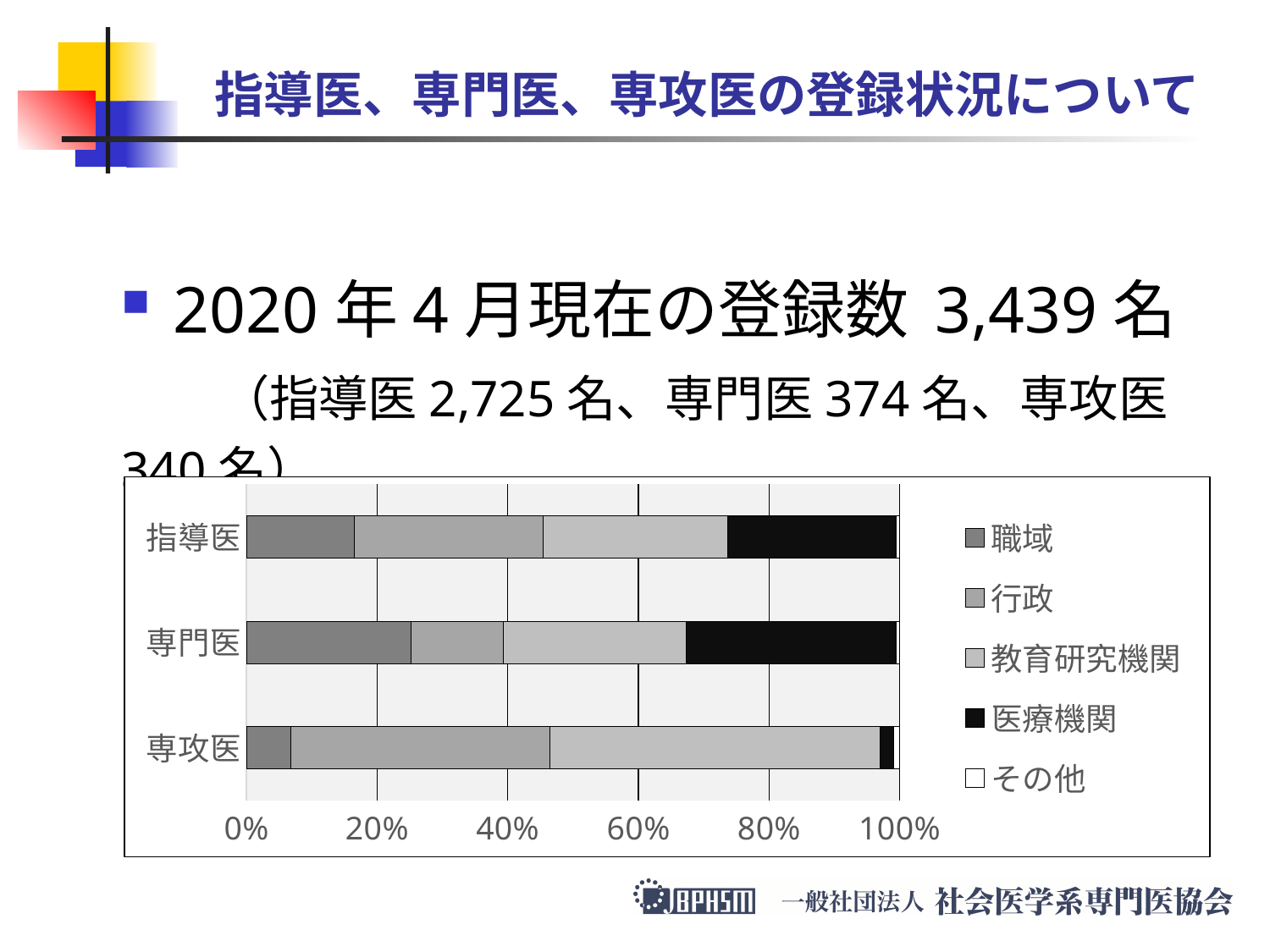
Is the 職域 share for 専攻医 greater or less than 20%? less Which series is shown in black in the chart legend? 医療機関 Is the 医療機関 share for 指導医 greater or less than 20%? greater Which category has the largest 行政 share? 専攻医 Is the 医療機関 share for 専攻医 greater or less than 20%? less What kind of chart is shown on the slide? stacked bar chart What is the highest value shown on the horizontal axis of the chart? 100% Which category has the smallest 職域 share? 専攻医 How many categories are plotted on the vertical axis of the chart? 3 How many series does the chart legend list? 5 Which has the larger 医療機関 share, 指導医 or 専攻医? 指導医